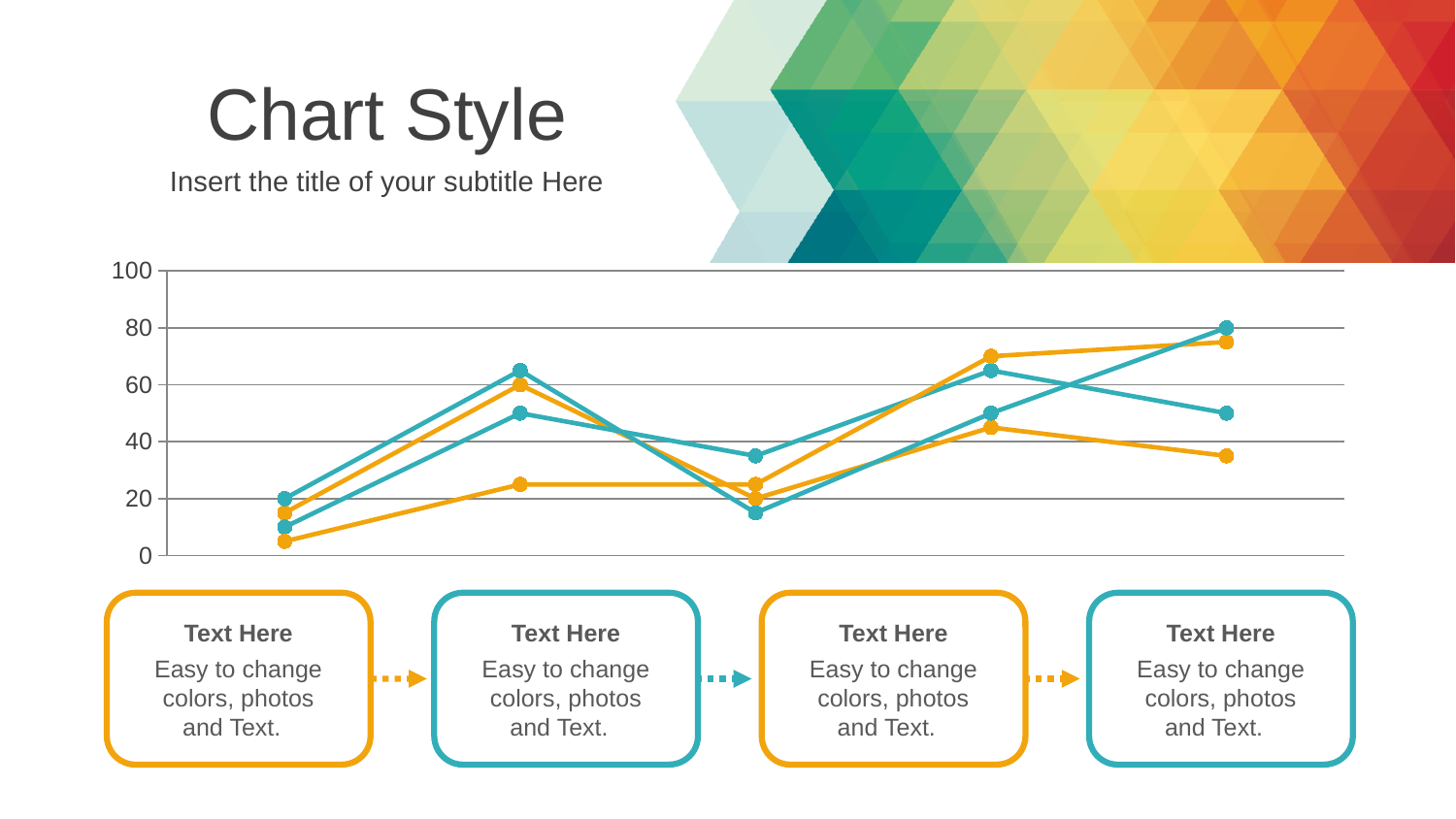
Is the highest point at the first x position greater or less than 40? less What is the maximum value shown on the y axis? 100 What is the highest value reached by any line on the chart? 80 What kind of chart is shown on the slide? line chart How many data points does each line on the chart have? 5 Is the lowest point on the chart greater or less than 20? less How many lines are plotted on the chart? 4 Does the line that ends at 80 rise or fall between its fourth and fifth points? rise What two colours are used for the lines on the chart? teal and orange Is the highest point at the last x position greater or less than 60? greater